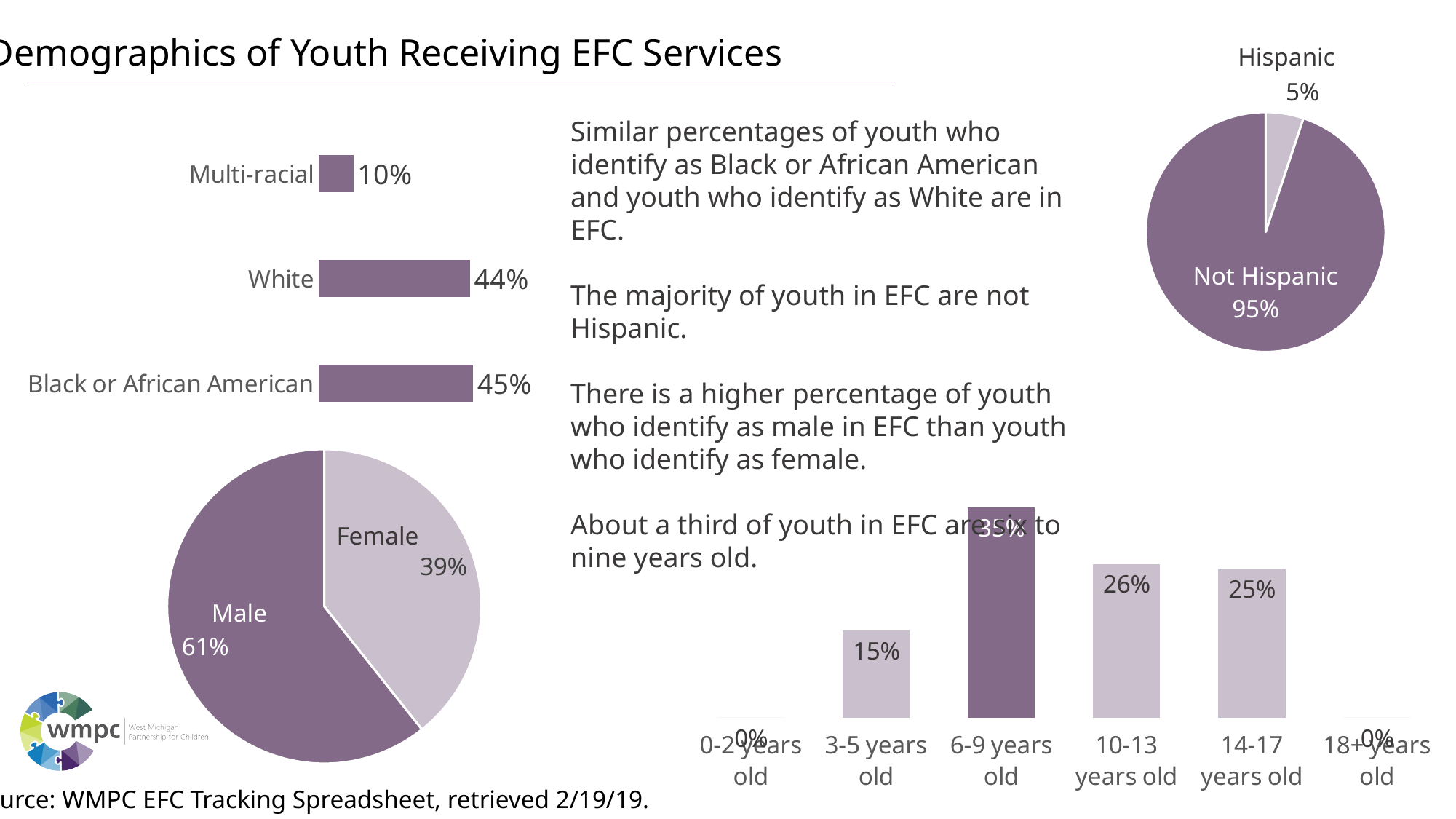
In the race bar chart on the top left, which category has the highest percentage? Black or African American In the race bar chart on the top left, what percentage is shown for Multi-racial? 10% How many categories are shown in the race bar chart on the top left? 3 In the age bar chart on the bottom right, what is the difference between the 14-17 years old and 3-5 years old percentages? 10% In the gender pie chart on the bottom left, what share of the pie is Male? 61% In the age bar chart on the bottom right, what percentage is shown for 10-13 years old? 26% In the age bar chart on the bottom right, which age group has the highest percentage? 6-9 years old In the gender pie chart on the bottom left, which is larger, Male or Female? Male In the Hispanic pie chart on the top right, what share is Hispanic? 5% In the race bar chart on the top left, what percentage is shown for White? 44% In the race bar chart on the top left, what is the difference between the Black or African American and Multi-racial percentages? 35% What kind of chart is the Hispanic / Not Hispanic chart on the top right? Pie chart